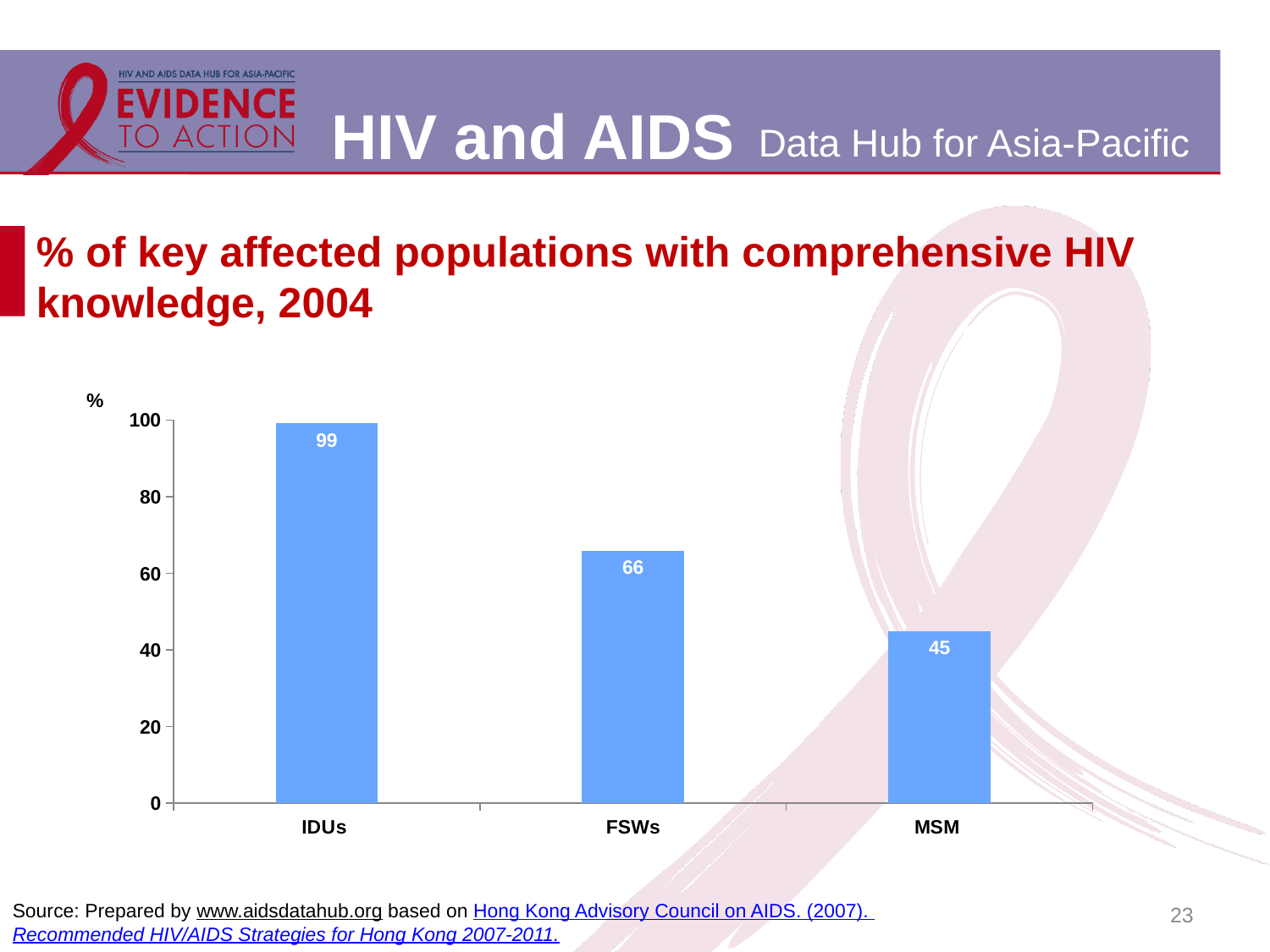
Which population has the highest percentage with comprehensive HIV knowledge? IDUs Which is larger, the value for FSWs or the value for MSM? FSWs Which population has the lowest percentage with comprehensive HIV knowledge? MSM What is the value for MSM? 45 Is the value for MSM greater or less than 60? less What is the difference between the values for FSWs and MSM? 21 What is the value for IDUs? 99 How many populations are shown on the chart? 3 What is the value for FSWs? 66 What kind of chart is shown on the slide? bar chart What is the difference between the values for IDUs and MSM? 54 What is the label on the vertical axis of the chart? %